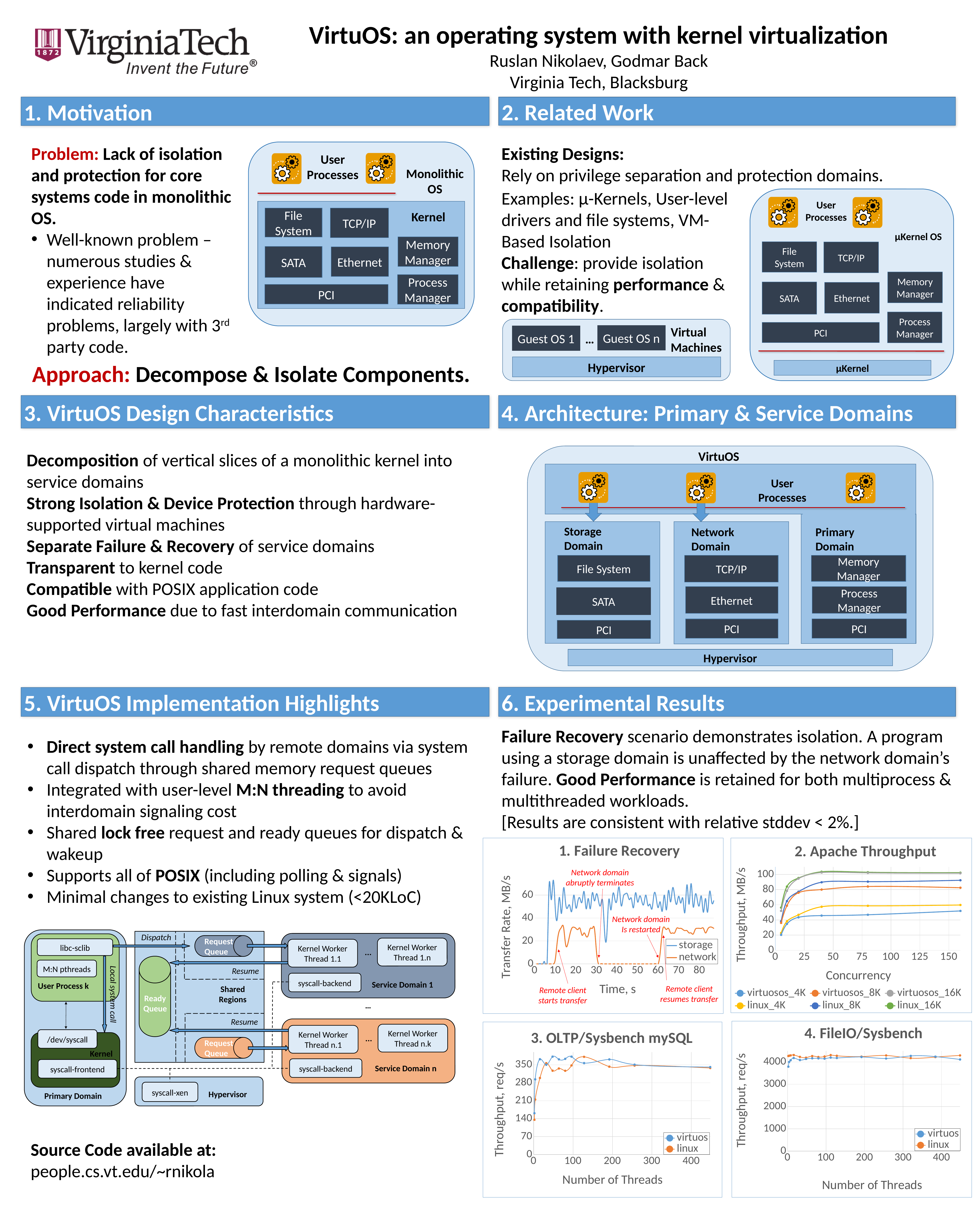
What is the x-axis label of the "2. Apache Throughput" chart? Concurrency In the "1. Failure Recovery" chart, is the network transfer rate at 40 s greater or less than 20 MB/s? less How many series does the legend of the "1. Failure Recovery" chart list? 2 In the "3. OLTP/Sysbench mySQL" chart, is the linux throughput at 400 threads greater or less than 280 req/s? greater In the "2. Apache Throughput" chart, is the value for virtuosos_16K at concurrency 150 greater or less than 80? greater In the "2. Apache Throughput" chart, does the virtuosos_16K throughput rise or fall as concurrency increases? rise How many series does the legend of the "2. Apache Throughput" chart list? 6 What kind of chart is the "1. Failure Recovery" chart? line chart